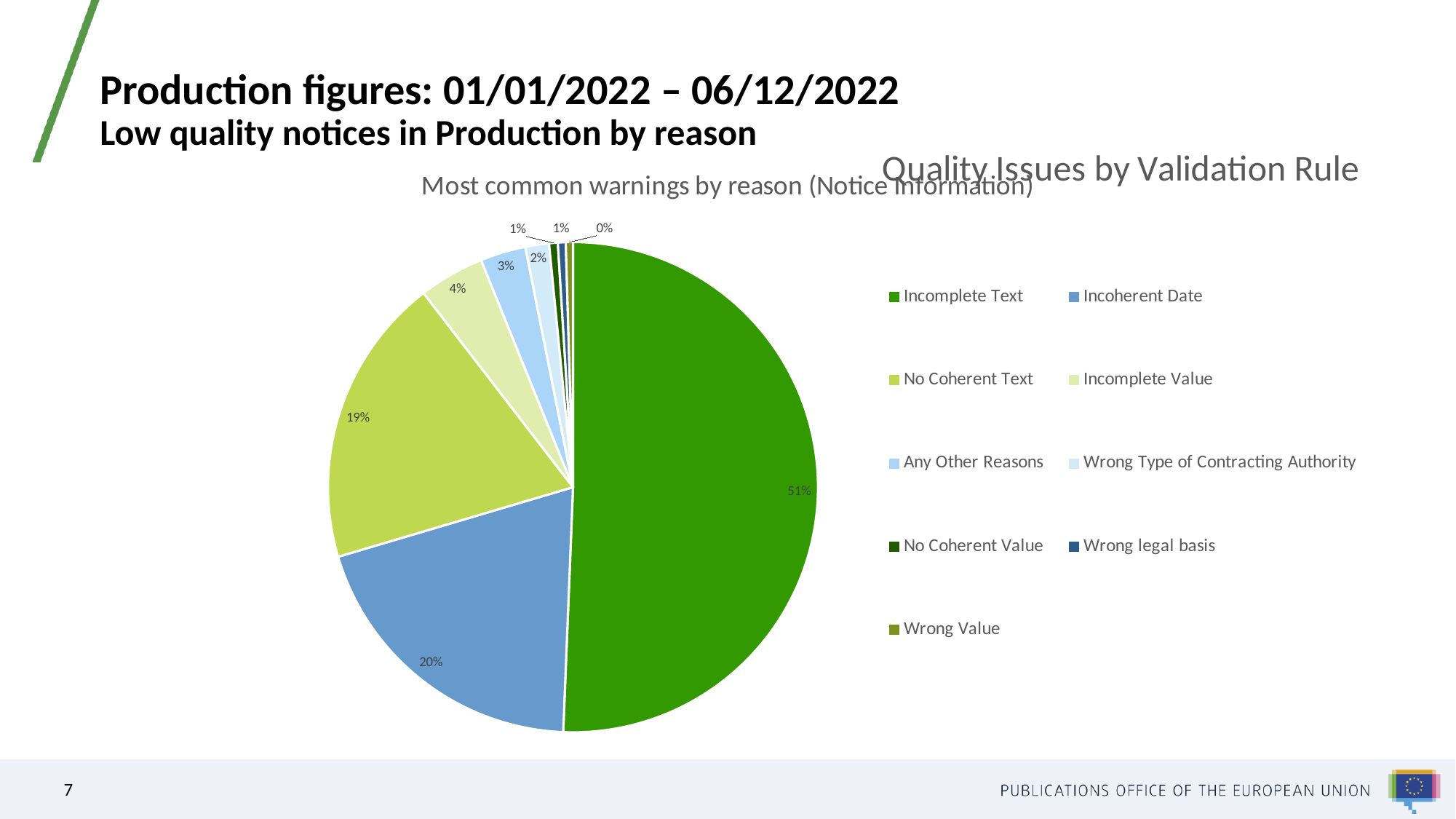
Which reason has the largest share of the pie? Incomplete Text What is the value shown for Incoherent Date? 20% Which reason has the smallest share of the pie? Wrong Value What is the title of the pie chart? Most common warnings by reason (Notice Information) How many reasons are listed in the legend of the pie chart? 9 What kind of chart is shown on the slide? pie chart Which is larger, the share for Incoherent Date or the share for No Coherent Text? Incoherent Date What is the value shown for Incomplete Value? 4% What share of the pie does Incomplete Text account for? 51% What is the value shown for Any Other Reasons? 3% What is the value shown for No Coherent Text? 19% How many percentage points larger is the Incomplete Text share than the Incoherent Date share? 31